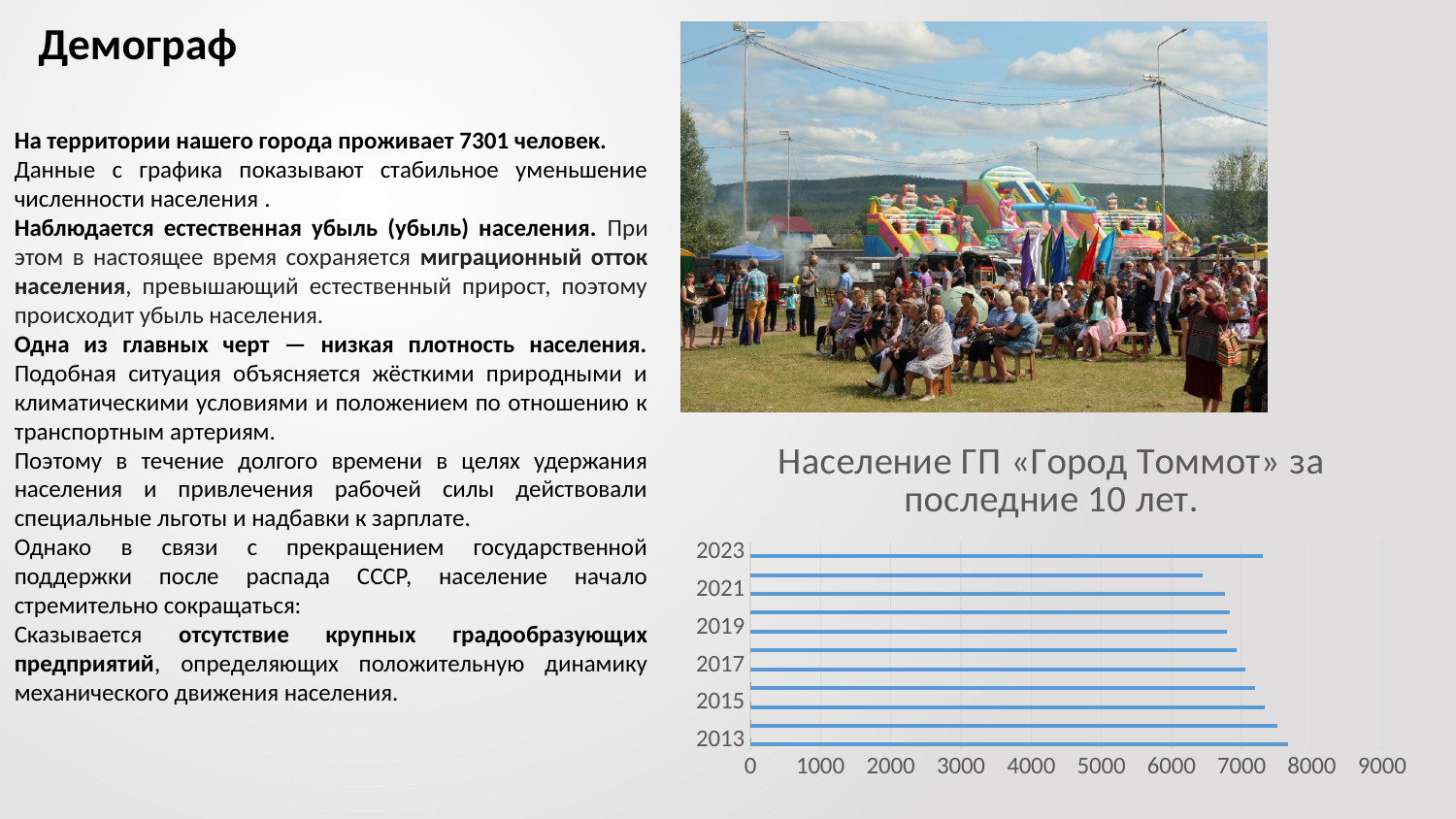
Is the value for 2019 greater or less than 6000? greater Is the value for 2023 greater or less than 6000? greater Which year has the larger value, 2023 or 2021? 2023 Which year has the larger value, 2013 or 2021? 2013 How many bars (years) are plotted in the chart? 11 Is the value for 2015 greater or less than 8000? less What is the highest value shown on the horizontal axis of the chart? 9000 What kind of chart is shown on the slide? bar chart What is the title of the chart? Население ГП «Город Томмот» за последние 10 лет. Do the bars generally get shorter or longer going from 2013 up to 2021? shorter